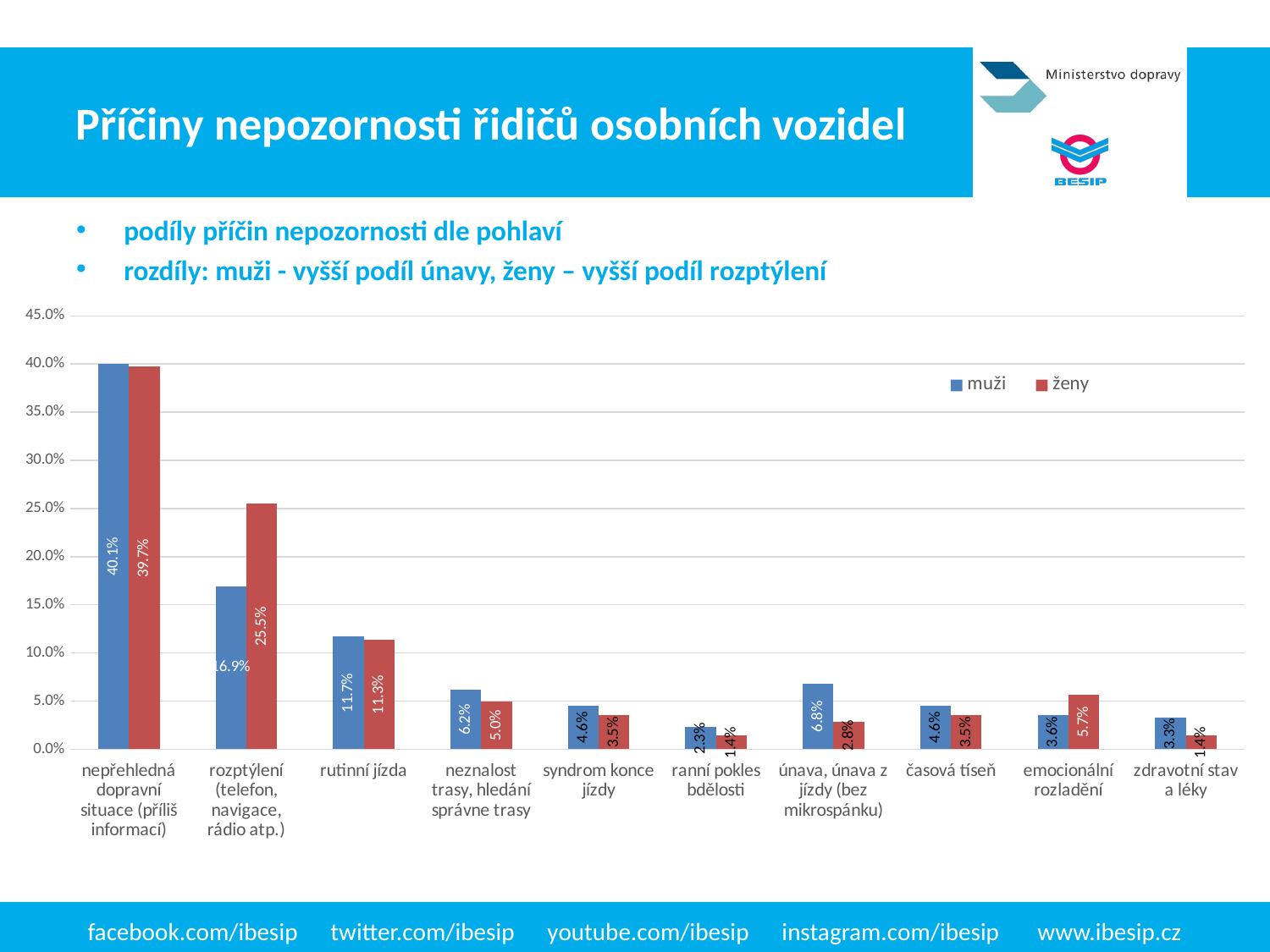
How many series does the legend list? 2 What kind of chart is shown on the slide? bar chart Which is larger in the category únava, únava z jízdy (bez mikrospánku): the value for muži or for ženy? muži Which category has the lowest value for muži? ranní pokles bdělosti What is the value for muži in the category rozptýlení (telefon, navigace, rádio atp.)? 16.9% What is the value for ženy in the category emocionální rozladění? 5.7% Which category has the highest value for ženy? nepřehledná dopravní situace (příliš informací) How many categories are shown on the x axis? 10 Is the value for muži in the category rutinní jízda greater or less than 10.0%? greater Which colour represents the series ženy in the chart? red What is the difference between the ženy and muži values in the category rozptýlení (telefon, navigace, rádio atp.)? 8.6% What is the value for muži in the category únava, únava z jízdy (bez mikrospánku)? 6.8%